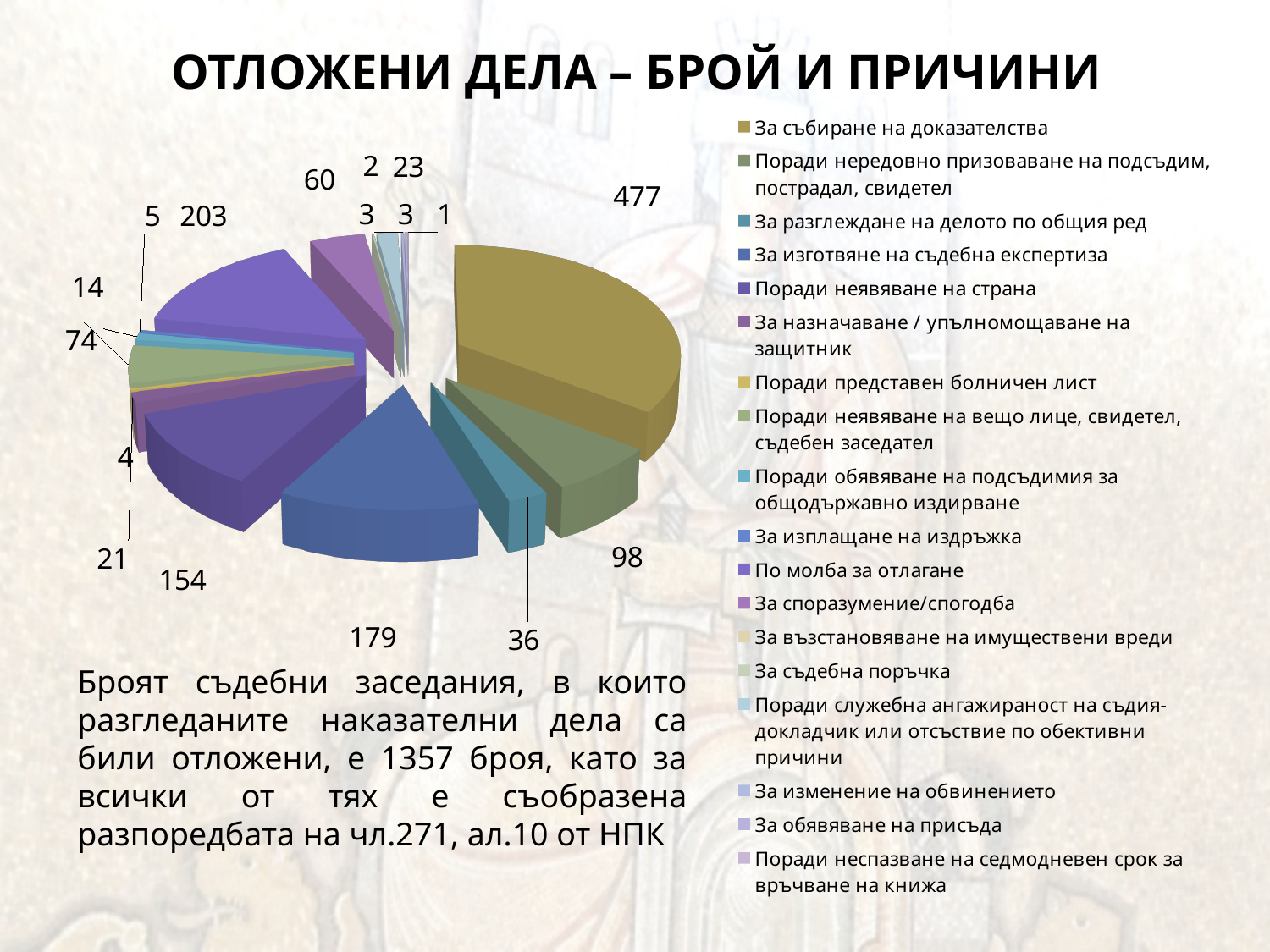
What is the difference between the values 203 and 179 shown on the chart? 24 What is the value for 'За събиране на доказателства'? 477 What is the smallest value labelled on the pie chart? 1 What is the difference between the largest slice (477) and the second largest slice (203)? 274 What is the value for 'За изготвяне на съдебна експертиза'? 179 Which is larger: 'За изготвяне на съдебна експертиза' or 'Поради неявяване на страна'? За изготвяне на съдебна експертиза What type of chart is shown on the slide? Pie chart What is the largest value shown on the pie chart? 477 How many categories does the chart legend list? 18 What is the value for 'По молба за отлагане'? 203 What is the title of the slide's chart? ОТЛОЖЕНИ ДЕЛА – БРОЙ И ПРИЧИНИ What is the value for 'Поради неявяване на страна'? 154